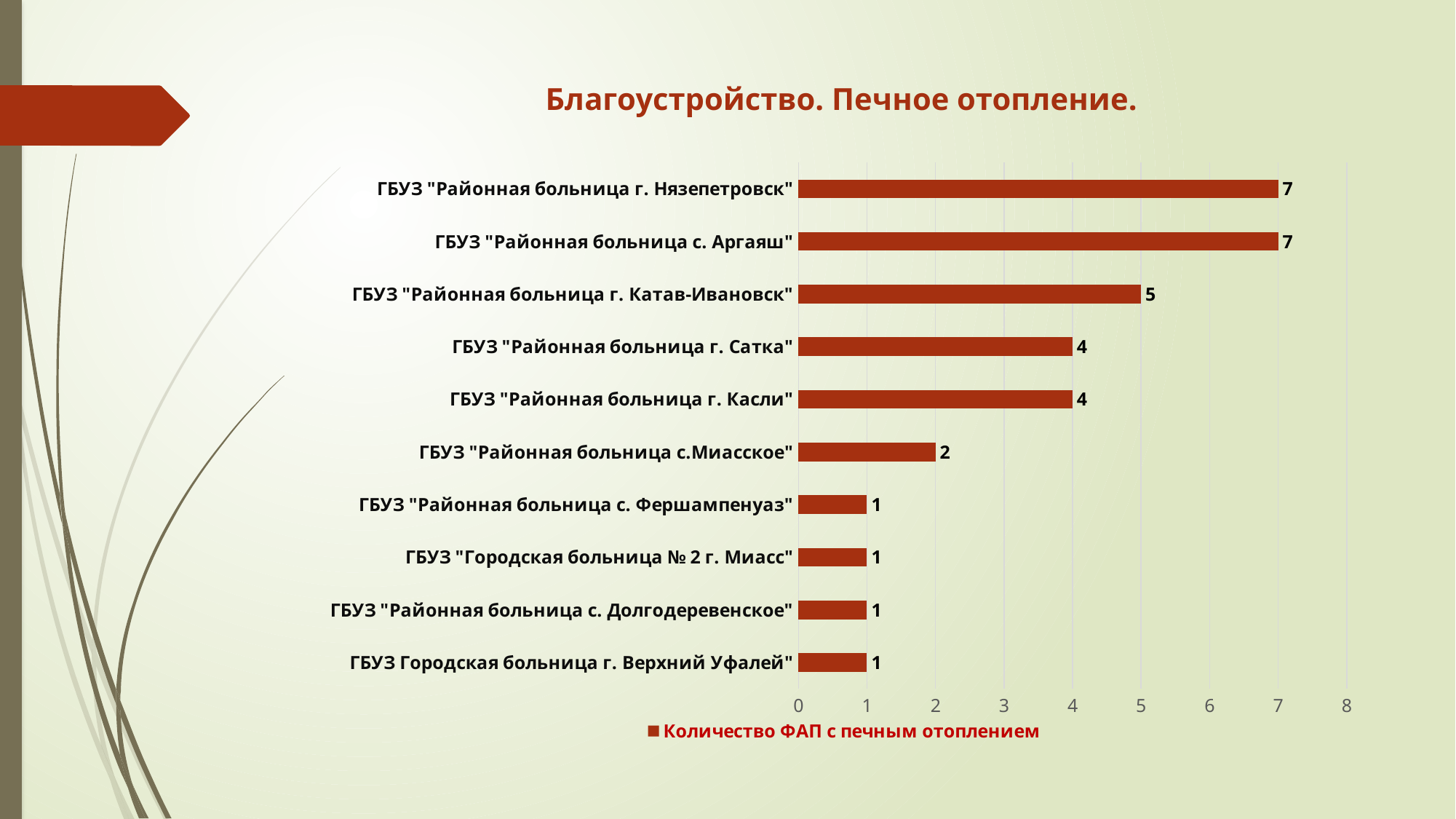
What is the difference between the values for ГБУЗ "Районная больница г. Касли" and ГБУЗ "Районная больница с.Миасское"? 2 What is the value for ГБУЗ "Районная больница с.Миасское"? 2 Is the value for ГБУЗ "Районная больница г. Катав-Ивановск" greater or less than 3? greater What is the legend entry of the chart? Количество ФАП с печным отоплением What is the value for ГБУЗ "Районная больница г. Сатка"? 4 What is the value for ГБУЗ "Городская больница № 2 г. Миасс"? 1 What is the value for ГБУЗ "Районная больница г. Катав-Ивановск"? 5 How many series does the legend list? 1 What is the difference between the values for ГБУЗ "Районная больница г. Нязепетровск" and ГБУЗ "Районная больница г. Катав-Ивановск"? 2 How many categories are shown in the chart? 10 Which is larger, the value for ГБУЗ "Районная больница с. Аргаяш" or the value for ГБУЗ "Районная больница г. Сатка"? ГБУЗ "Районная больница с. Аргаяш" What kind of chart is shown on the slide? bar chart